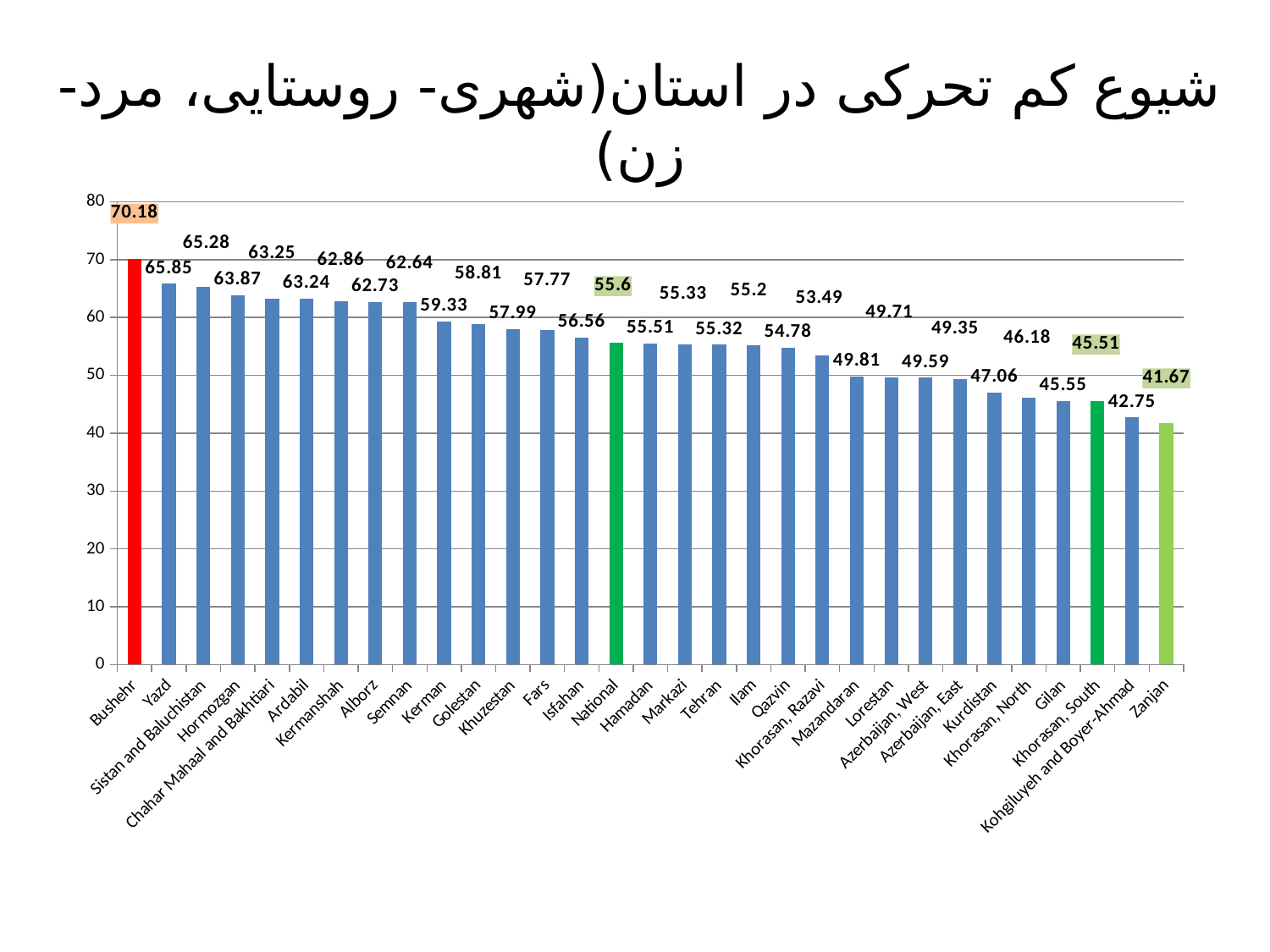
How many bars are shown in the chart? 31 Which category has the highest value? Bushehr What is the value for National? 55.6 What kind of chart is shown on the slide? bar chart Do the values rise or fall from left to right along the x axis? fall What is the value for Bushehr? 70.18 Which category has the lowest value? Zanjan What is the difference between the values for Bushehr and Zanjan? 28.51 What is the value for Tehran? 55.32 What is the value for Zanjan? 41.67 Which is larger, the value for Yazd or the value for Kerman? Yazd Is the value for Kurdistan greater or less than 50? less